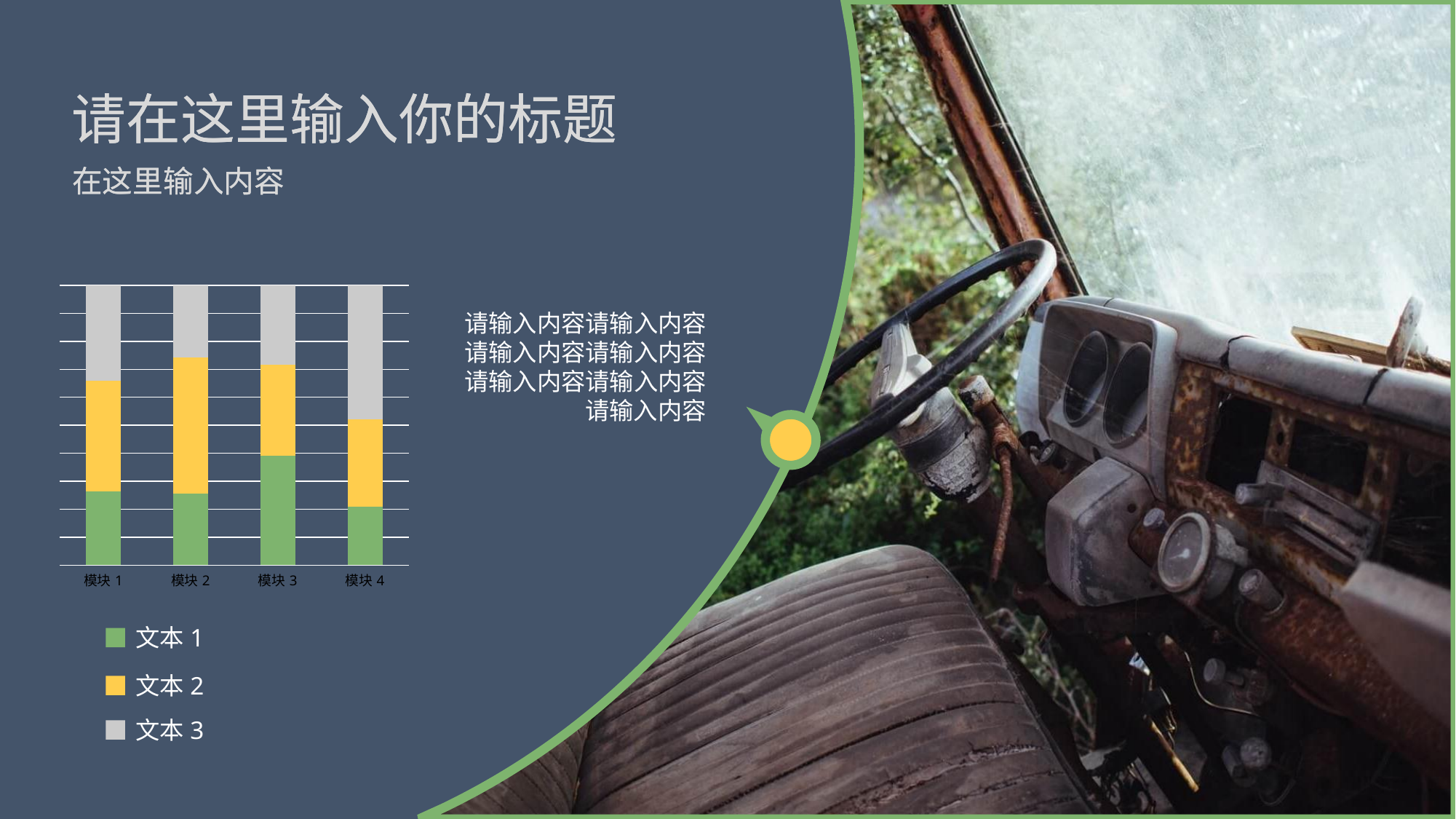
Is the 文本 3 segment larger for 模块 4 or for 模块 1? 模块 4 What is the label of the first category on the x axis? 模块 1 How many categories are shown on the x axis of the chart? 4 Is the 文本 2 segment larger for 模块 2 or for 模块 3? 模块 2 What colour represents the series 文本 2 in the chart? yellow Is the 文本 1 segment larger for 模块 3 or for 模块 4? 模块 3 Which category has the largest 文本 2 (yellow) segment? 模块 2 How many series does the chart's legend list? 3 Which category has the largest 文本 3 (grey) segment? 模块 4 Which category has the largest 文本 1 (green) segment? 模块 3 Which category has the smallest 文本 1 (green) segment? 模块 4 What kind of chart is shown on the slide? stacked bar chart